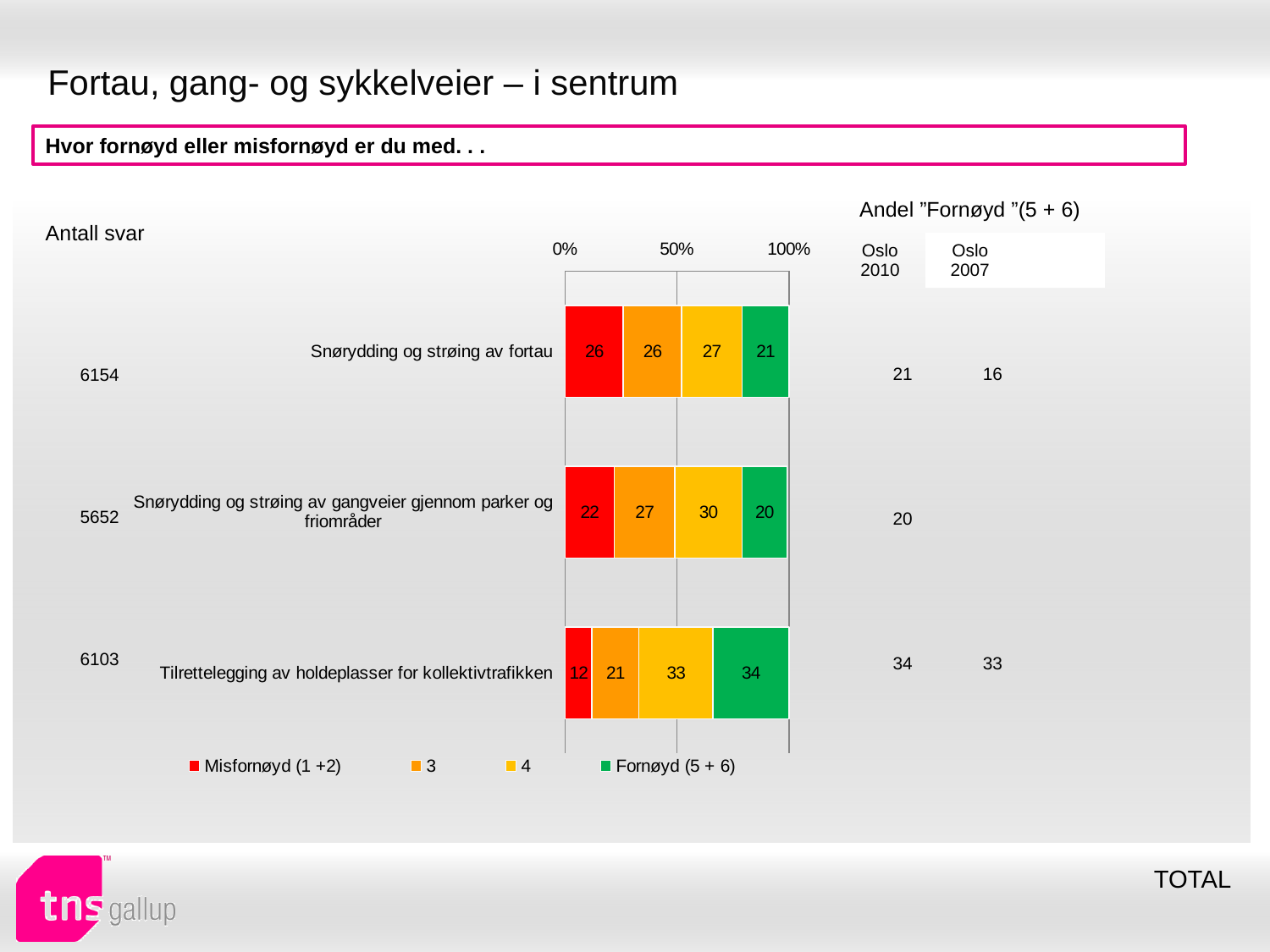
What is the value of the "4" segment for "Snørydding og strøing av gangveier gjennom parker og friområder"? 30 What kind of chart is shown on the slide? Stacked bar chart Which category has the lowest "Misfornøyd (1 +2)" value? Tilrettelegging av holdeplasser for kollektivtrafikken How many categories are shown in the chart? 3 Which category has the highest "Fornøyd (5 + 6)" value? Tilrettelegging av holdeplasser for kollektivtrafikken What is the total of the stacked bar for "Snørydding og strøing av gangveier gjennom parker og friområder"? 99 How many series does the legend list? 4 What is the value of the "Fornøyd (5 + 6)" segment for "Tilrettelegging av holdeplasser for kollektivtrafikken"? 34 What is the value of the "Misfornøyd (1 +2)" segment for "Snørydding og strøing av fortau"? 26 Which is larger: the "3" segment for "Snørydding og strøing av gangveier gjennom parker og friområder" or the "3" segment for "Tilrettelegging av holdeplasser for kollektivtrafikken"? Snørydding og strøing av gangveier gjennom parker og friområder Which colour represents the "Fornøyd (5 + 6)" series in the legend? Green What is the difference between the "Misfornøyd (1 +2)" values for "Snørydding og strøing av fortau" and "Tilrettelegging av holdeplasser for kollektivtrafikken"? 14